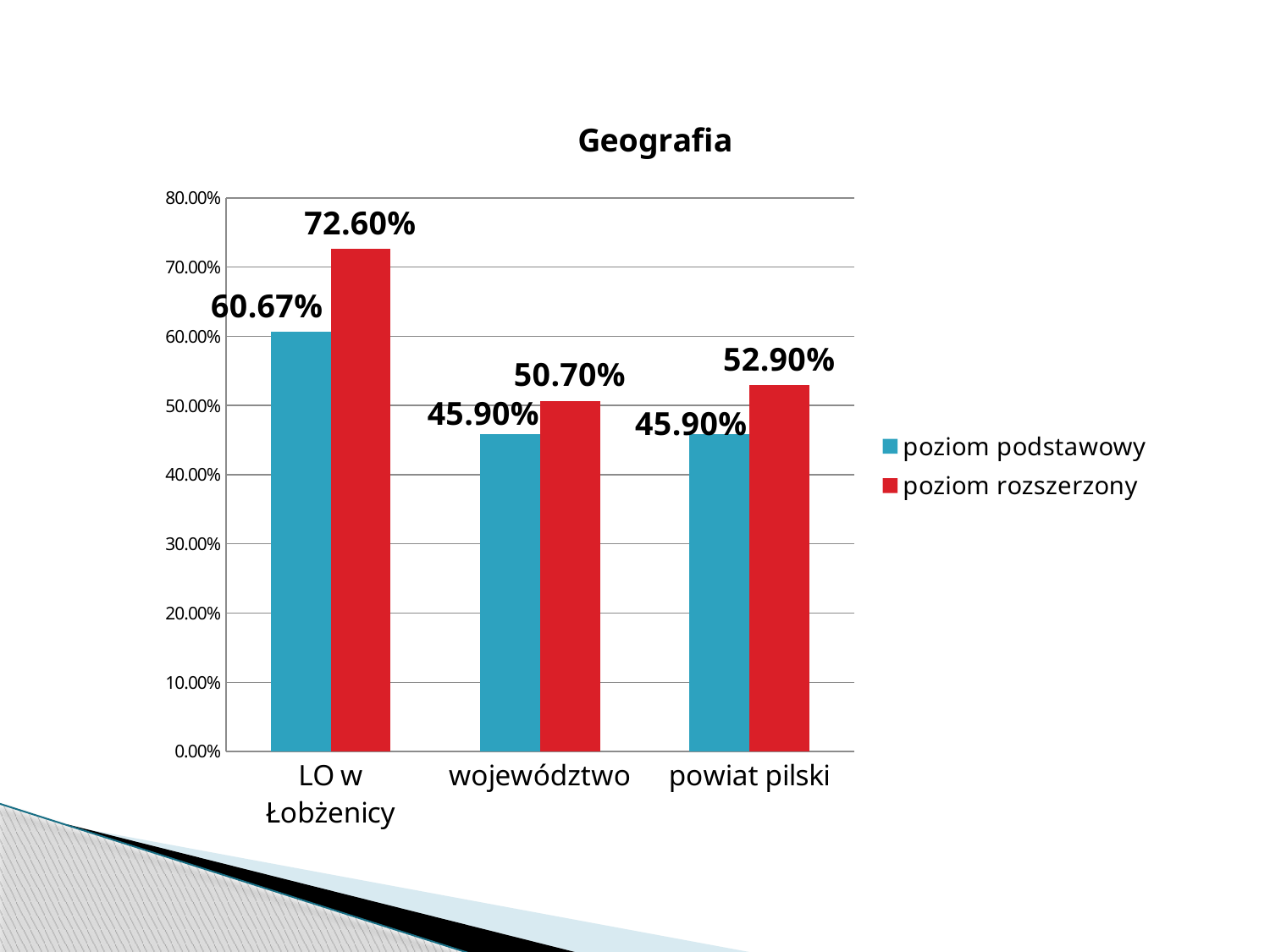
How many series does the legend list? 2 What is the difference between poziom rozszerzony and poziom podstawowy at LO w Łobżenicy? 11.93% What is the difference between poziom rozszerzony at powiat pilski and at województwo? 2.20% Which category has the lowest value for poziom rozszerzony? województwo Is the value for poziom rozszerzony at LO w Łobżenicy greater or less than 70.00%? greater What type of chart is shown? bar chart Which category has the highest value for poziom rozszerzony? LO w Łobżenicy What is the value for poziom podstawowy at LO w Łobżenicy? 60.67% What is the value for poziom rozszerzony at powiat pilski? 52.90% How many categories are shown on the x axis? 3 Which is larger at powiat pilski: poziom podstawowy or poziom rozszerzony? poziom rozszerzony What is the value for poziom rozszerzony at województwo? 50.70%